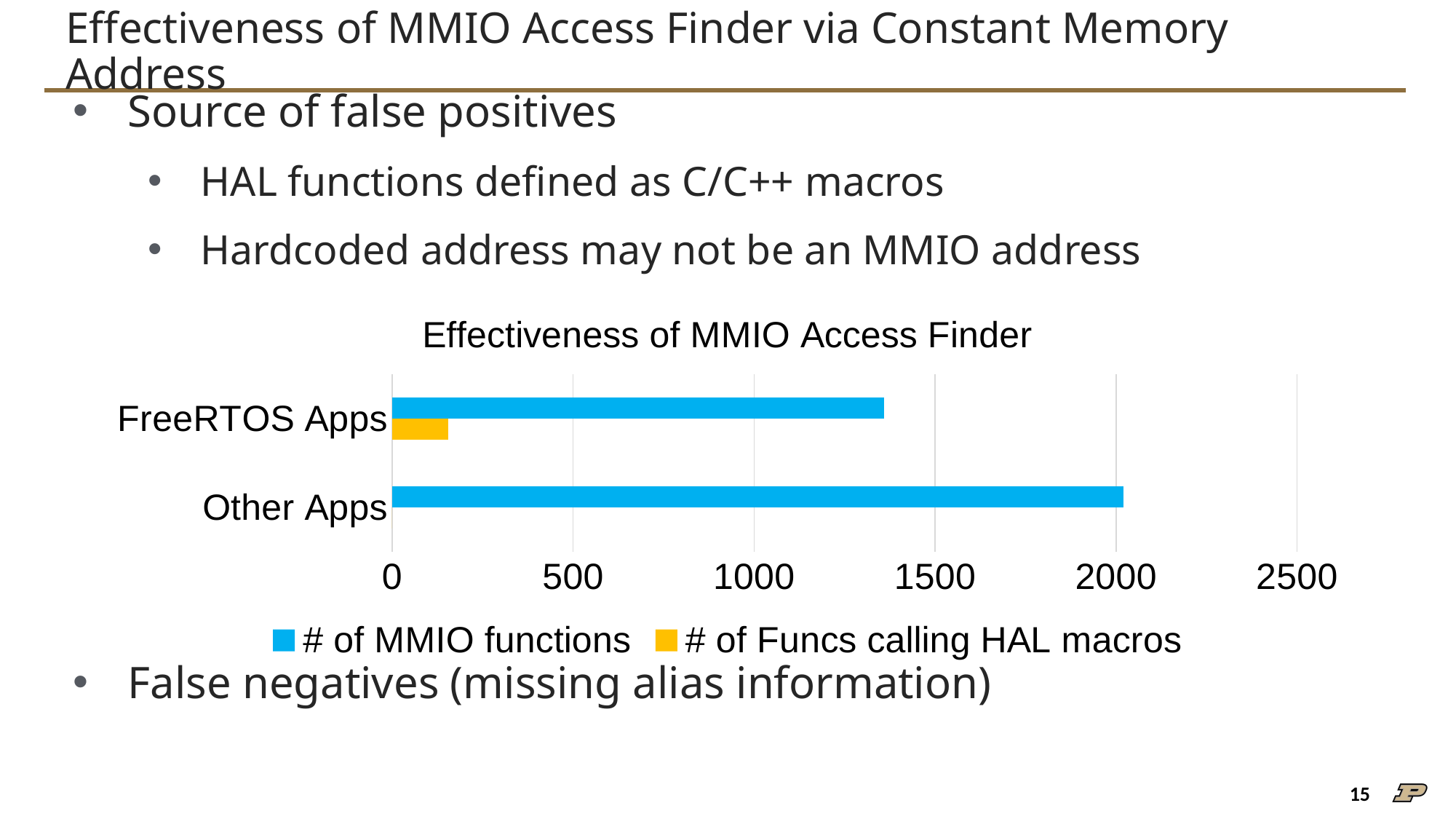
Is the value for # of MMIO functions for FreeRTOS Apps greater or less than 1500? less Is the value for # of MMIO functions for Other Apps greater or less than 1500? greater For FreeRTOS Apps, which is larger: # of MMIO functions or # of Funcs calling HAL macros? # of MMIO functions Is the value for # of Funcs calling HAL macros for FreeRTOS Apps greater or less than 500? less Which category has the higher value for # of MMIO functions? Other Apps What is the title of the chart? Effectiveness of MMIO Access Finder What kind of chart is shown on the slide? bar chart How many categories are shown on the chart's vertical axis? 2 What is the largest value shown on the chart's horizontal axis? 2500 Which series is drawn in yellow in the chart? # of Funcs calling HAL macros How many series does the chart legend list? 2